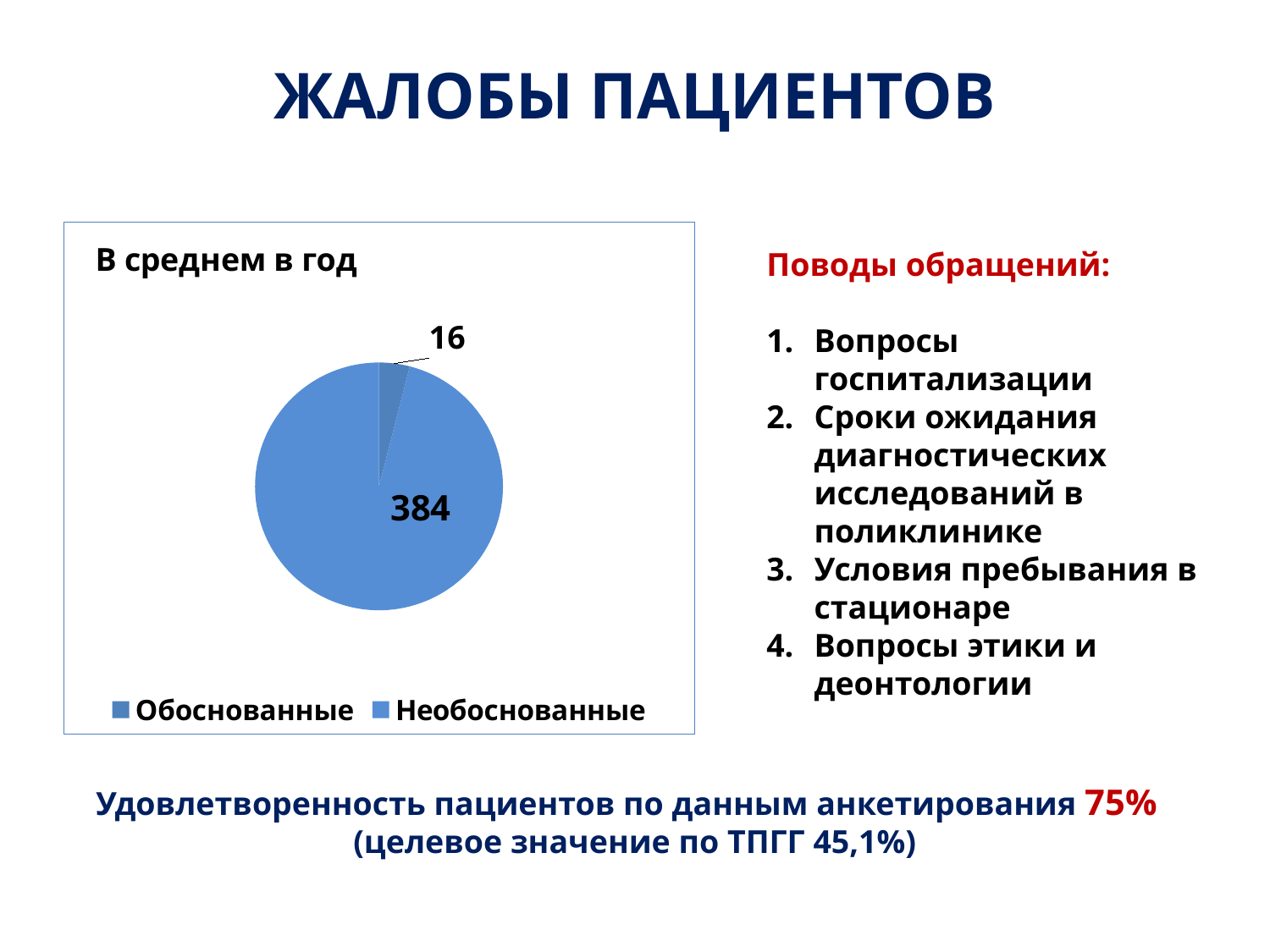
How many entries does the legend of the pie chart list? 2 What is the title of the pie chart? В среднем в год Which is larger, the value for Обоснованные or the value for Необоснованные? Необоснованные What share of the pie does the Обоснованные slice represent? 4% What is the difference between the values for Необоснованные and Обоснованные? 368 What kind of chart is shown on the slide? Pie chart What is the total of the two values shown in the pie chart? 400 What is the value for Необоснованные in the pie chart? 384 How many slices does the pie chart have? 2 What is the value for Обоснованные in the pie chart? 16 Which category has the smallest slice in the pie chart? Обоснованные Which category has the largest slice in the pie chart? Необоснованные